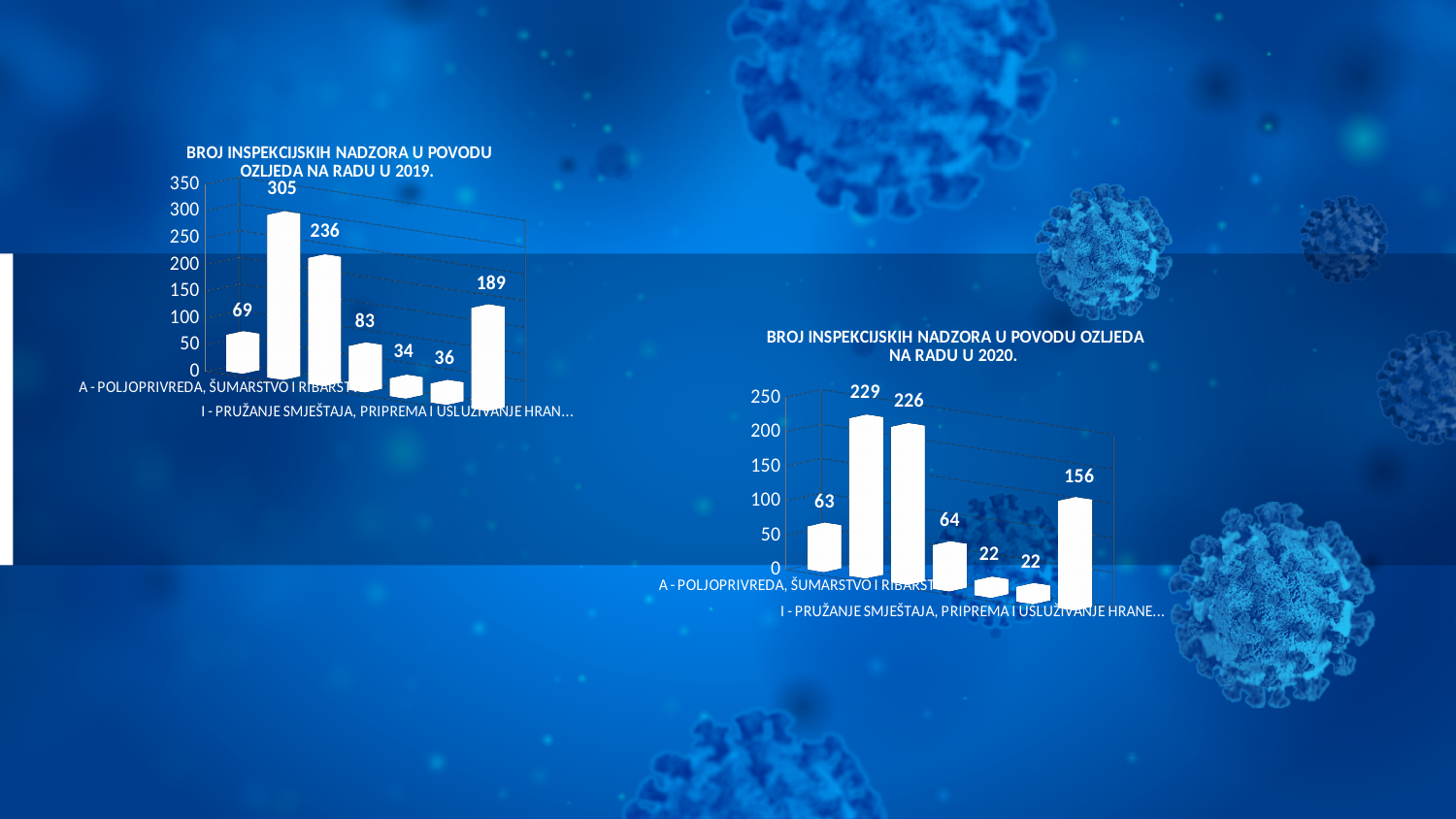
In the 2019 chart on the left, what is the highest value shown? 305 In the 2019 chart on the left, what is the lowest value shown? 34 What is the title of the chart on the right side of the slide? BROJ INSPEKCIJSKIH NADZORA U POVODU OZLJEDA NA RADU U 2020. In the 2020 chart on the right, what is the lowest value shown? 22 In the 2019 chart on the left, what is the difference between the highest value (305) and the lowest value (34)? 271 In the 2019 chart on the left, what is the value for 'A - POLJOPRIVREDA, ŠUMARSTVO I RIBARSTVO'? 69 In the 2020 chart on the right, what is the difference between the last bar (156) and the first bar (63)? 93 What kind of chart is the chart titled 'BROJ INSPEKCIJSKIH NADZORA U POVODU OZLJEDA NA RADU U 2019.'? bar chart In the 2020 chart on the right, what is the value for 'A - POLJOPRIVREDA, ŠUMARSTVO I RIBARSTVO'? 63 In the 2020 chart on the right, what is the highest value shown? 229 Which is larger: the value for 'A - POLJOPRIVREDA, ŠUMARSTVO I RIBARSTVO' in the 2019 chart or in the 2020 chart? 2019 chart In the 2019 chart on the left, how many bars are plotted? 7